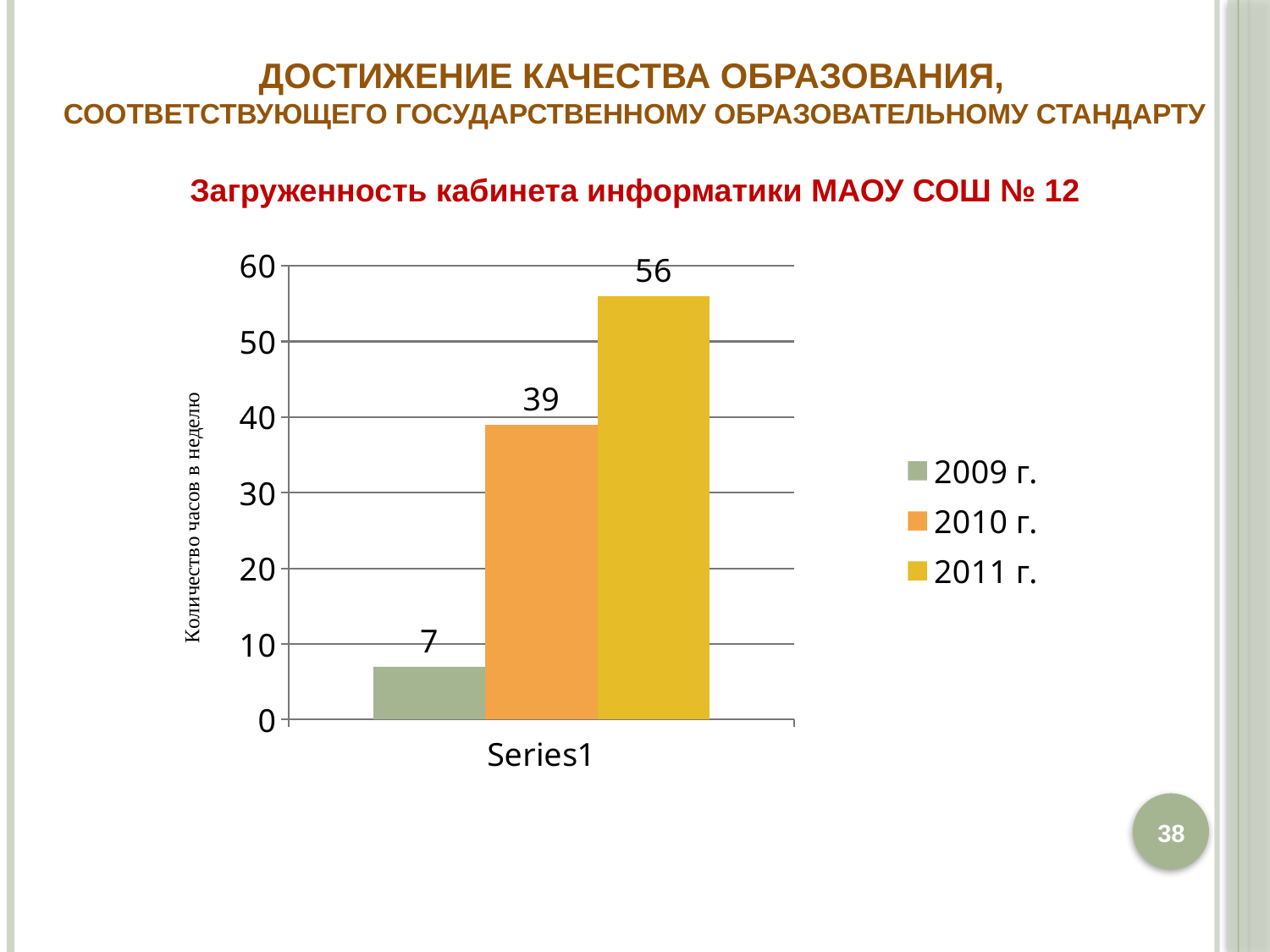
What is the difference between the values for 2010 г. and 2009 г.? 32 Which year has the highest value? 2011 г. Which year has the lowest value? 2009 г. What is the value for 2009 г.? 7 What is the difference between the values for 2011 г. and 2010 г.? 17 Which is larger, the value for 2010 г. or the value for 2009 г.? 2010 г. What kind of chart is shown on the slide? bar chart What is the value for 2010 г.? 39 Is the value for 2011 г. greater or less than 50? greater What is the value for 2011 г.? 56 What is the label of the vertical axis? Количество часов в неделю How many series does the legend list? 3